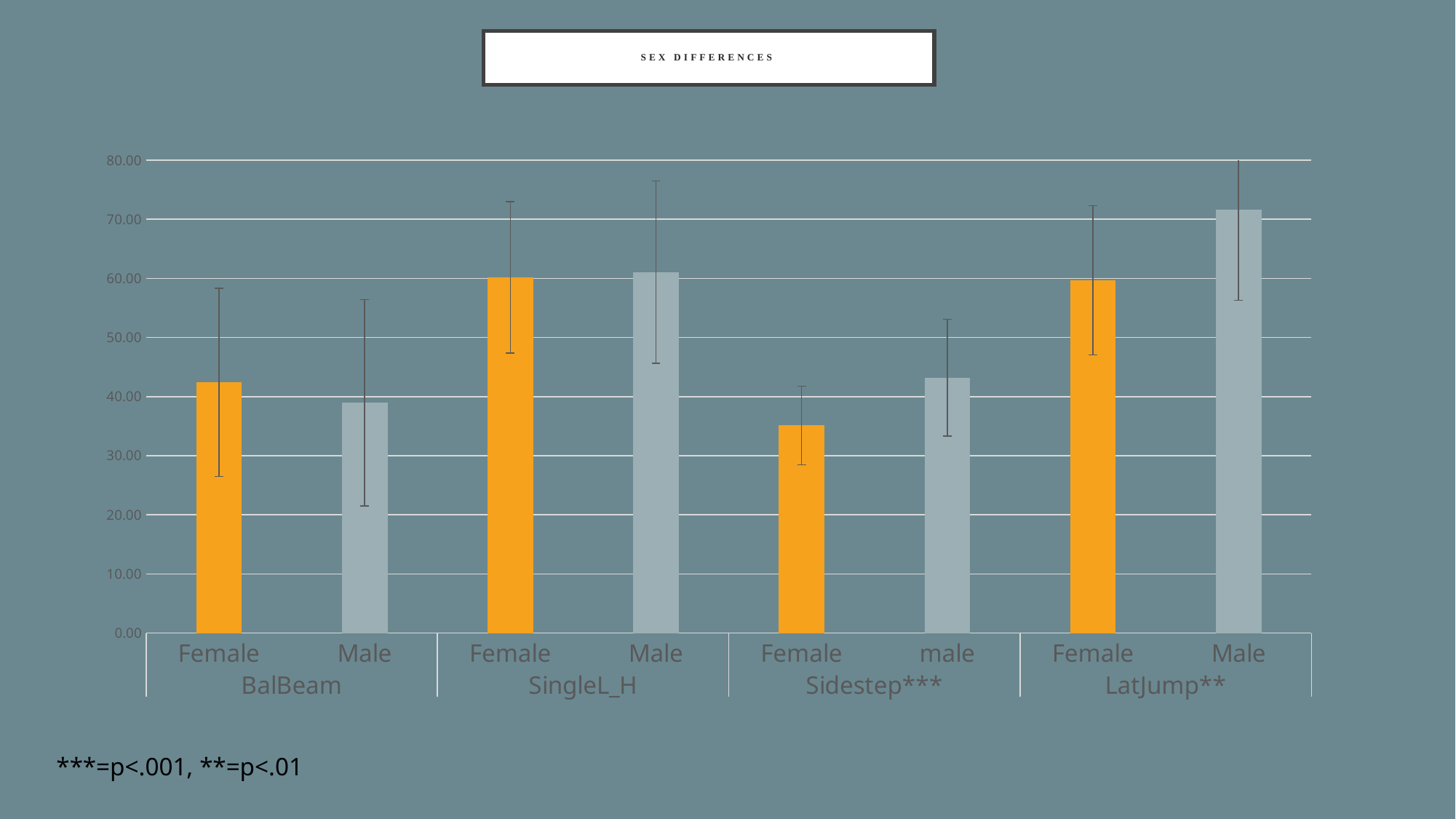
Is the value for Sidestep*** Female greater or less than 40.00? less Is the value for LatJump** Male greater or less than 60.00? greater How many bars are plotted in the chart? 8 Which bar is the lowest in the chart? Sidestep*** Female How many task groups are shown along the x axis? 4 In the LatJump** group, which is larger, the Female bar or the Male bar? Male What colour are the Female bars in the chart? orange What kind of chart is shown on the slide? bar chart Is the value for SingleL_H Male greater or less than 50.00? greater In the Sidestep*** group, which is larger, the Female bar or the male bar? male What is the title shown above the chart? SEX DIFFERENCES Which bar is the highest in the chart? LatJump** Male